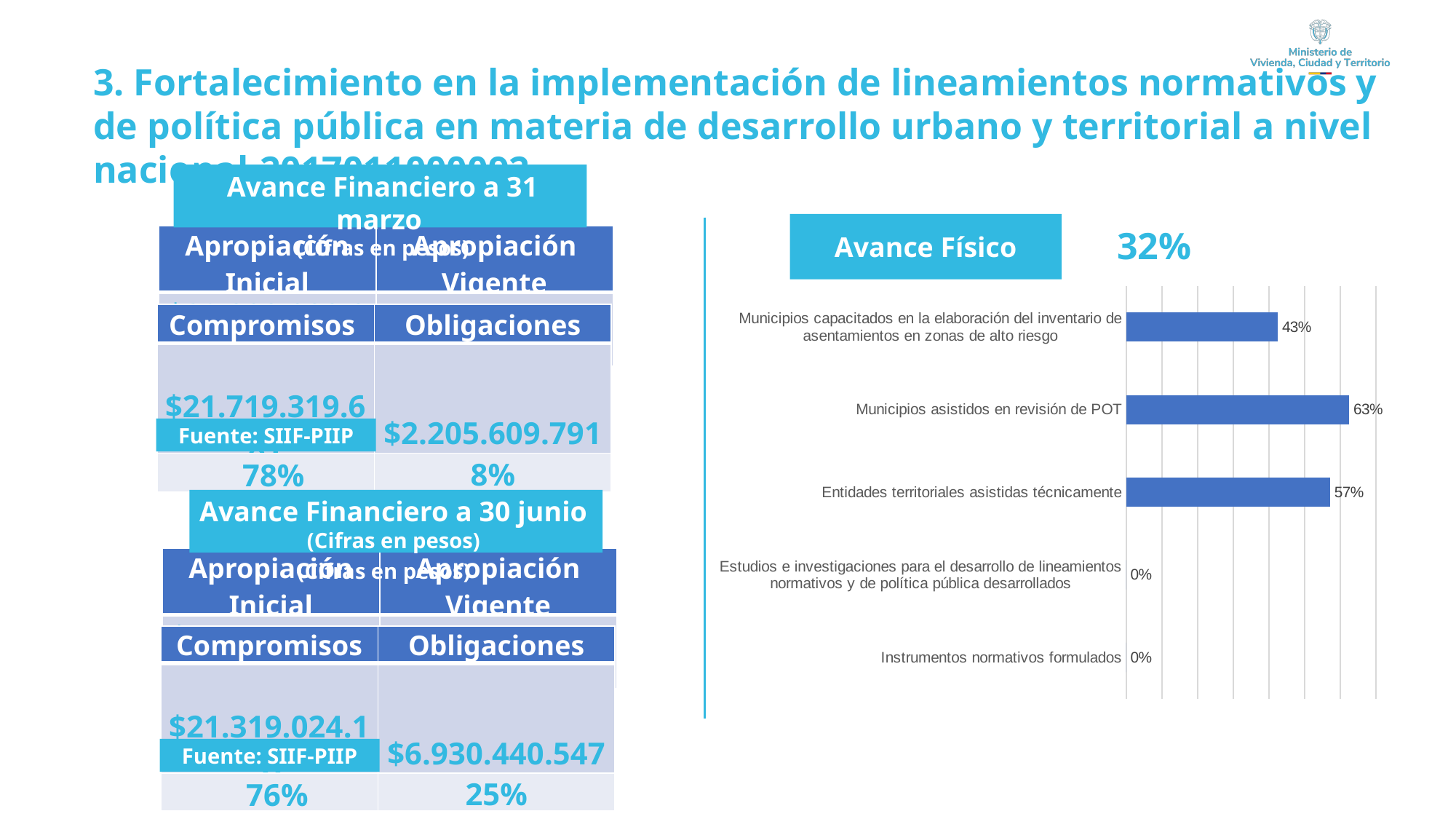
In the "Avance Físico" chart, what is the difference between the values for "Municipios asistidos en revisión de POT" and "Municipios capacitados en la elaboración del inventario de asentamientos en zonas de alto riesgo"? 20% In the "Avance Físico" chart, what is the value for "Municipios capacitados en la elaboración del inventario de asentamientos en zonas de alto riesgo"? 43% In the "Avance Físico" chart, which category has the highest value? Municipios asistidos en revisión de POT In the "Avance Físico" chart, which is larger: the value for "Entidades territoriales asistidas técnicamente" or the value for "Municipios capacitados en la elaboración del inventario de asentamientos en zonas de alto riesgo"? Entidades territoriales asistidas técnicamente In the "Avance Físico" chart, what is the value for "Instrumentos normativos formulados"? 0% In the "Avance Físico" chart, what is the value for "Entidades territoriales asistidas técnicamente"? 57% In the "Avance Físico" chart, what is the difference between the values for "Municipios asistidos en revisión de POT" and "Entidades territoriales asistidas técnicamente"? 6% In the "Avance Físico" chart, what is the value for "Municipios asistidos en revisión de POT"? 63% In the "Avance Físico" chart, how many categories have a value of 0%? 2 What overall percentage is displayed next to the "Avance Físico" heading above the chart? 32% In the "Avance Físico" chart, how many categories are plotted? 5 What type of chart is shown under the "Avance Físico" heading? bar chart